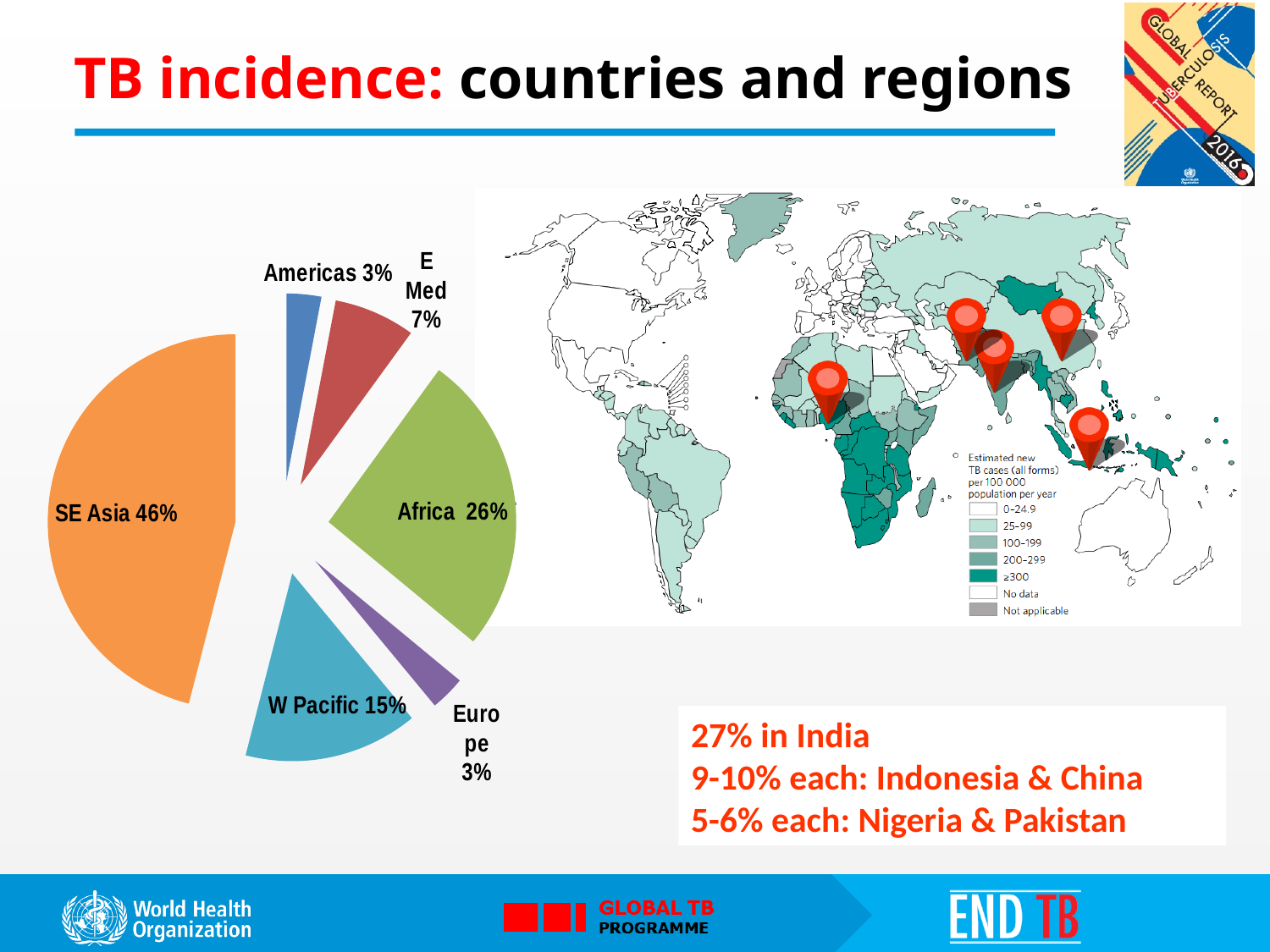
According to the text box on the slide, what percentage of TB incidence is in India? 27% In the pie chart, what is the value shown for E Med? 7% In the pie chart, what share of TB incidence is attributed to SE Asia? 46% In the pie chart, what is the value shown for the Americas? 3% In the pie chart, which is larger: Africa or W Pacific? Africa Which region has the largest slice in the pie chart? SE Asia In the pie chart, what is the value shown for Africa? 26% In the pie chart, what is the value shown for W Pacific? 15% How many slices does the pie chart have? 6 In the pie chart, how many percentage points larger is SE Asia than Africa? 20 In the pie chart, what is the combined share of SE Asia and Africa? 72% What kind of chart is shown on the left of the slide? pie chart